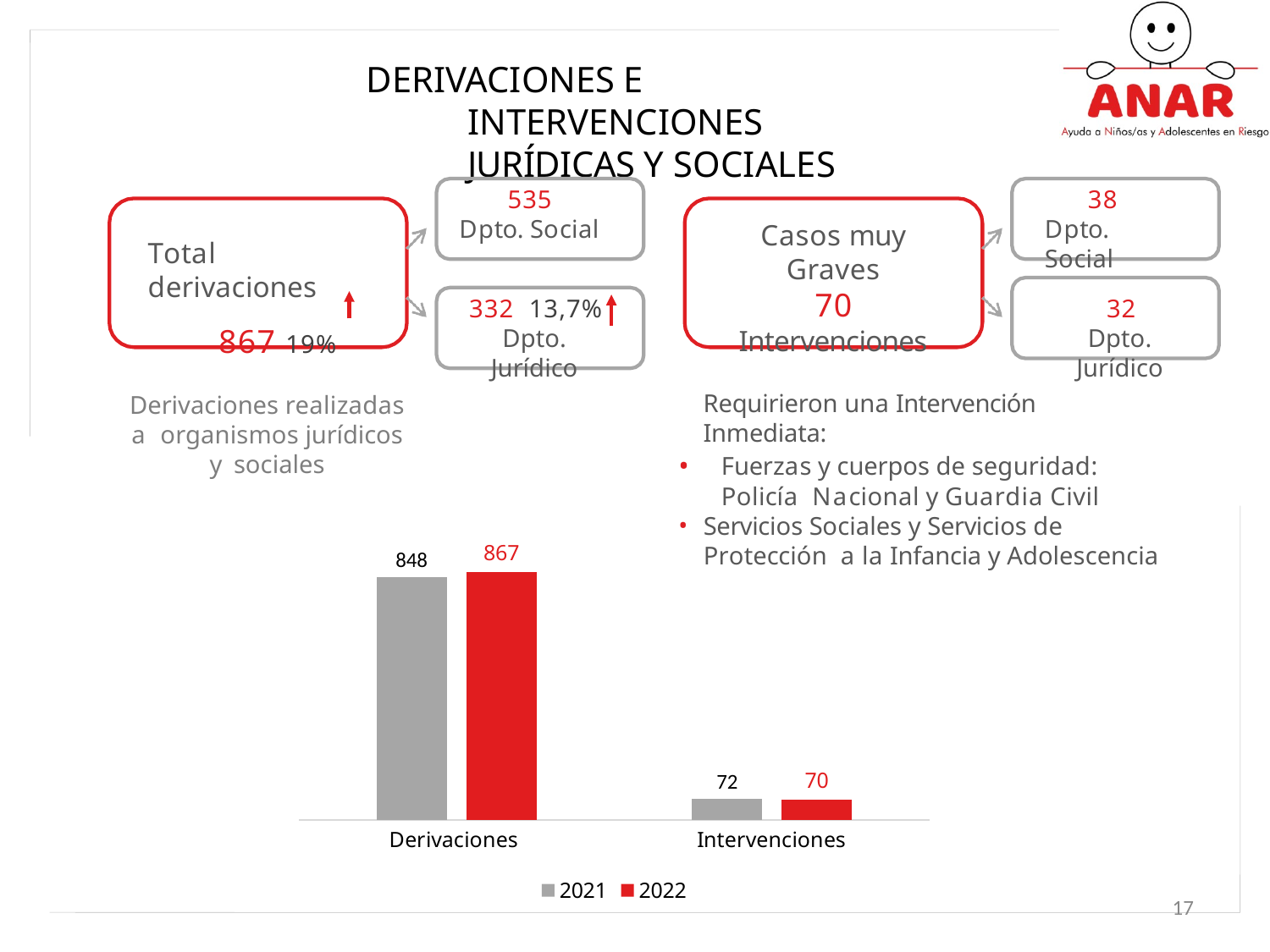
What is the difference between the 2022 and 2021 values for Derivaciones? 19 Which is larger for Derivaciones: the 2021 value or the 2022 value? 2022 What is the value for Derivaciones in 2022? 867 What kind of chart is shown on the slide? Bar chart How many series does the chart legend list? 2 What is the difference between the 2021 and 2022 values for Intervenciones? 2 How many categories are shown on the x axis of the chart? 2 What is the value for Intervenciones in 2021? 72 Which category has the lowest value in the 2021 series? Intervenciones What is the value for Derivaciones in 2021? 848 What is the value for Intervenciones in 2022? 70 Which category has the highest value in the 2022 series? Derivaciones